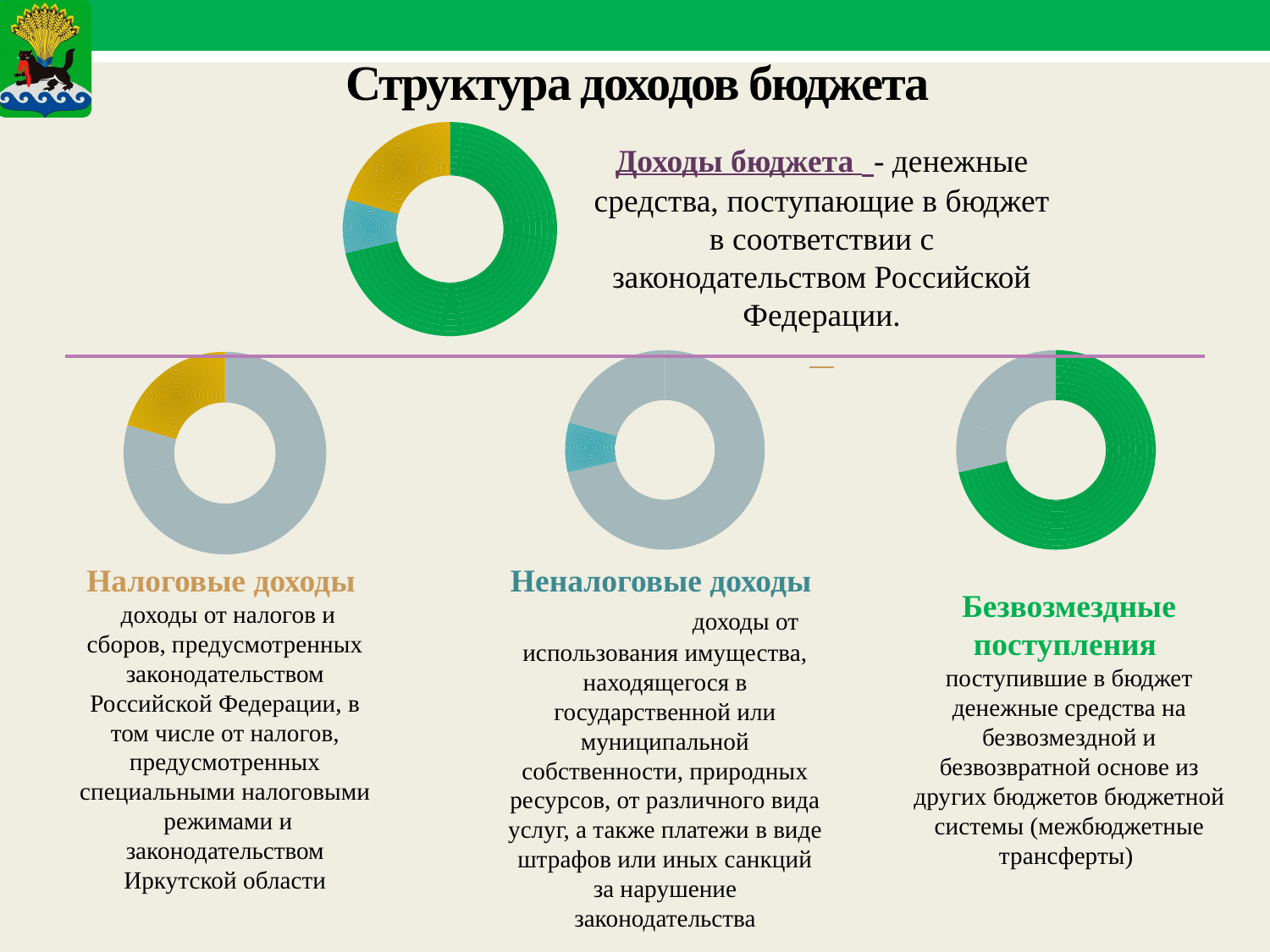
In the top doughnut chart, which colour slice is the smallest? teal In the top doughnut chart, which slice is larger, the yellow one or the teal one? yellow How many slices does the top doughnut chart have? 3 What colour is the highlighted slice in the bottom-left doughnut chart (above 'Налоговые доходы')? yellow How many doughnut charts are shown on the slide? 4 What kind of chart is the chart at the top of the slide, next to the definition of 'Доходы бюджета'? doughnut chart In the bottom-middle doughnut chart (above 'Неналоговые доходы'), which slice is larger, the teal one or the grey one? grey In the top doughnut chart, which colour slice is the largest? green What colour is the highlighted slice in the bottom-right doughnut chart (above 'Безвозмездные поступления')? green In the bottom-left doughnut chart (above 'Налоговые доходы'), which slice is larger, the yellow one or the grey one? grey